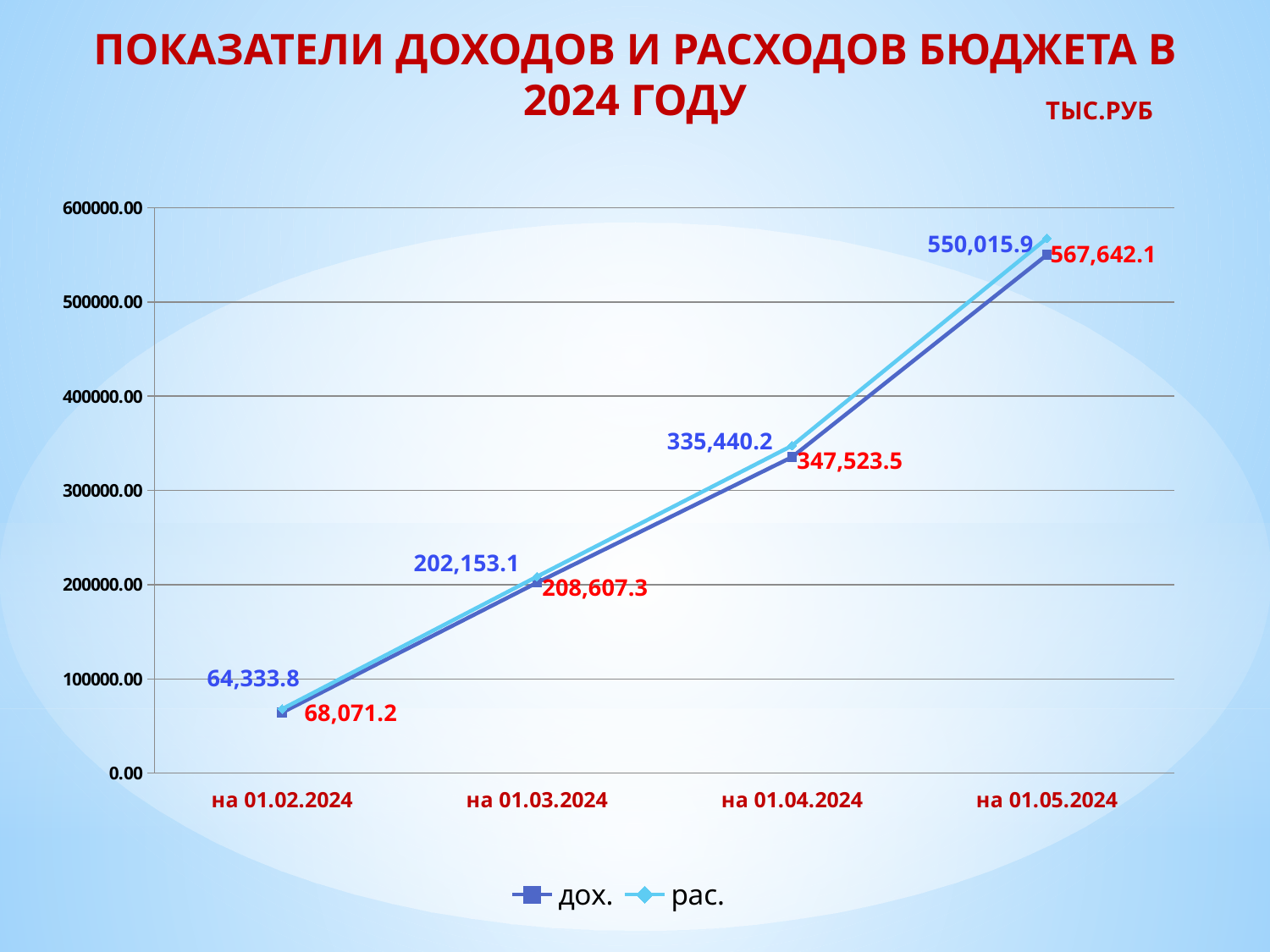
Do the values of дох. rise or fall from 01.02.2024 to 01.05.2024? rise On which date is the value of рас. lowest? на 01.02.2024 What is the value of дох. на 01.04.2024? 335,440.2 What is the value of дох. на 01.02.2024? 64,333.8 How many series does the legend list? 2 On which date is the value of дох. highest? на 01.05.2024 What is the value of рас. на 01.05.2024? 567,642.1 Which is larger на 01.04.2024, дох. or рас.? рас. How many dates are plotted along the x axis? 4 What type of chart is shown on the slide? line chart What is the value of рас. на 01.03.2024? 208,607.3 What is the difference between рас. and дох. на 01.05.2024? 17,626.2